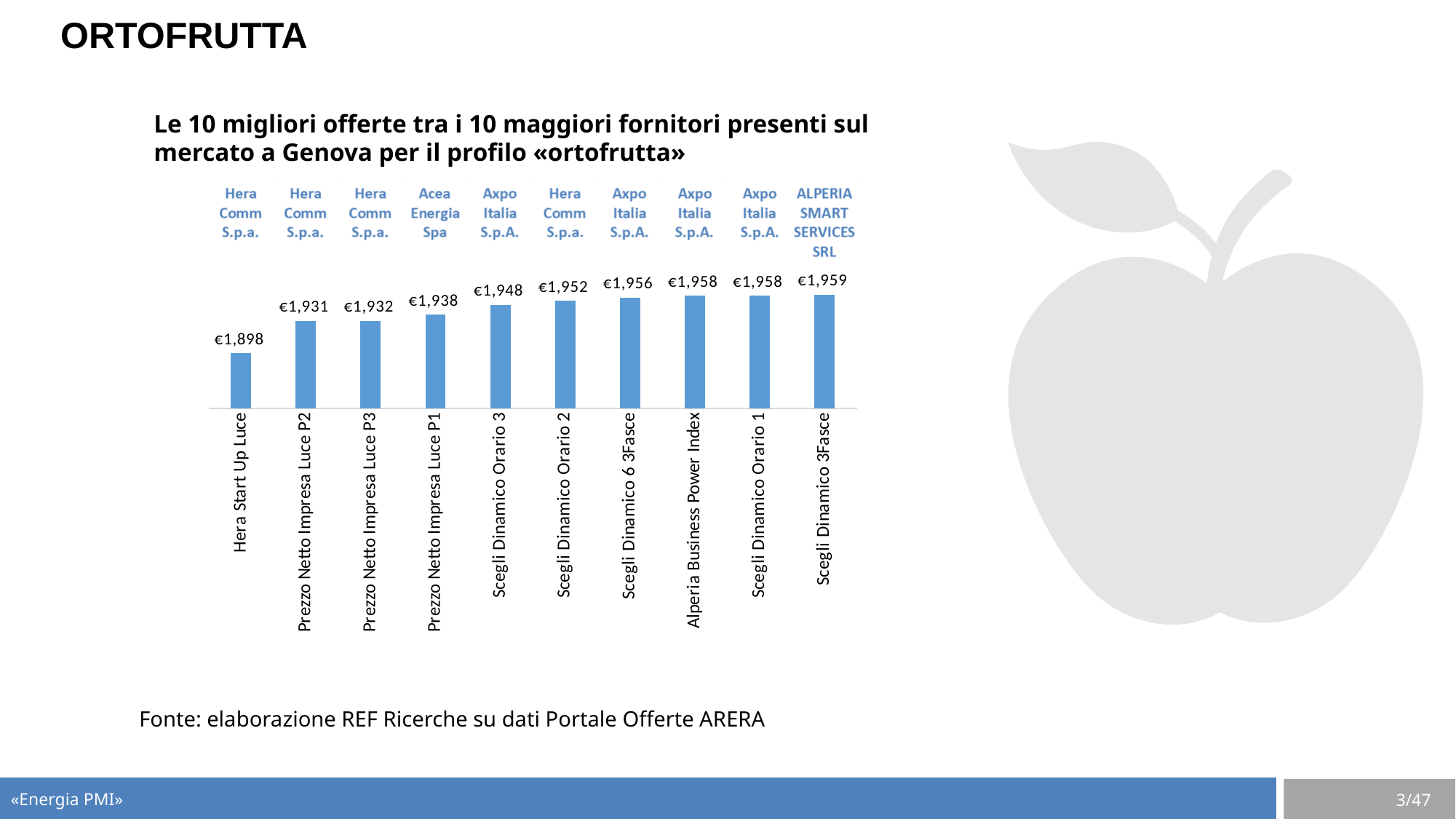
What is the value for the Scegli Dinamico 3Fasce offer? €1,959 Which offer has the highest value in the chart? Scegli Dinamico 3Fasce Do the values rise or fall from left to right across the chart? Rise What is the difference between the values for Prezzo Netto Impresa Luce P2 and Hera Start Up Luce? €0,033 Which offer has the lowest value in the chart? Hera Start Up Luce What type of chart is shown on the slide? Bar chart What is the value for the Alperia Business Power Index offer? €1,958 Which supplier is listed above the Alperia Business Power Index offer? Axpo Italia S.p.A. What is the value for the Prezzo Netto Impresa Luce P1 offer? €1,938 How many offers (bars) are shown in the chart? 10 Which has a larger value, Scegli Dinamico Orario 3 or Hera Start Up Luce? Scegli Dinamico Orario 3 What is the value for the Hera Start Up Luce offer? €1,898